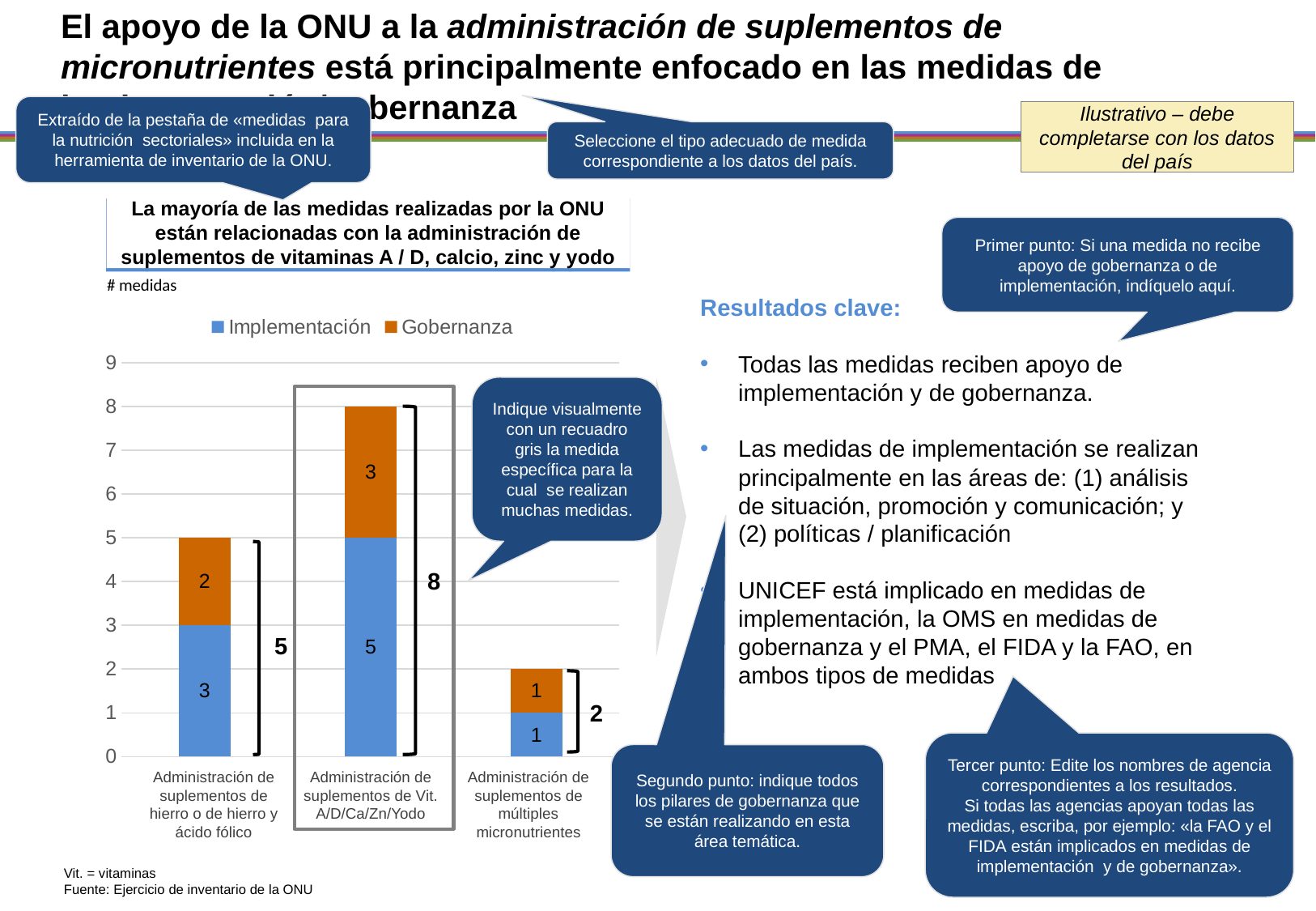
What is the difference between the Implementación values for 'Administración de suplementos de Vit. A/D/Ca/Zn/Yodo' and 'Administración de suplementos de hierro o de hierro y ácido fólico'? 2 Which category has the highest total number of measures? Administración de suplementos de Vit. A/D/Ca/Zn/Yodo What is the Implementación value for 'Administración de suplementos de Vit. A/D/Ca/Zn/Yodo'? 5 Which series is shown in orange in the chart legend? Gobernanza How many series does the chart legend list? 2 What is the Gobernanza value for 'Administración de suplementos de múltiples micronutrientes'? 1 What is the Gobernanza value for 'Administración de suplementos de hierro o de hierro y ácido fólico'? 2 What type of chart is shown on the slide? Stacked bar chart What is the total number of measures for 'Administración de suplementos de hierro o de hierro y ácido fólico'? 5 How many categories are shown on the x axis of the chart? 3 What is the total number of measures for 'Administración de suplementos de Vit. A/D/Ca/Zn/Yodo'? 8 Which category has the lowest total number of measures? Administración de suplementos de múltiples micronutrientes